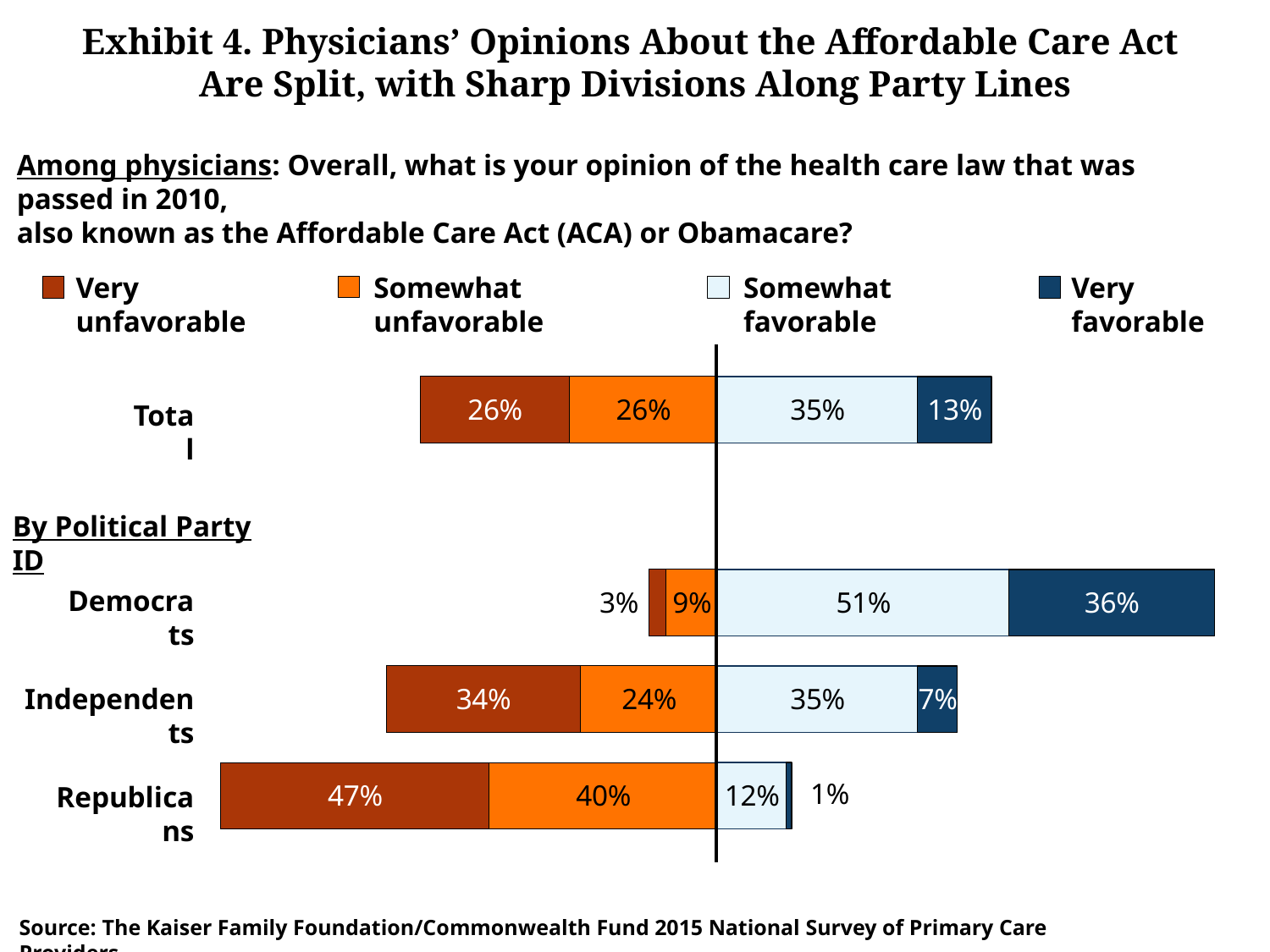
What percentage of Republicans are very unfavorable toward the ACA? 47% What is the somewhat favorable value for Independents? 35% Which group has the lowest very favorable percentage? Republicans What is the difference between the somewhat favorable percentages for Democrats and Republicans? 39 percentage points How many groups (bars) are shown in the chart? 4 What is the combined favorable (somewhat favorable plus very favorable) percentage for Democrats? 87% Which is larger: the somewhat unfavorable share for Independents or for Republicans? Republicans What type of chart is shown on the slide? Stacked bar chart Which group has the highest very unfavorable percentage? Republicans What is the very favorable value for the Total bar? 13% How many series does the legend list? 4 What percentage of Democrats are very favorable toward the ACA? 36%